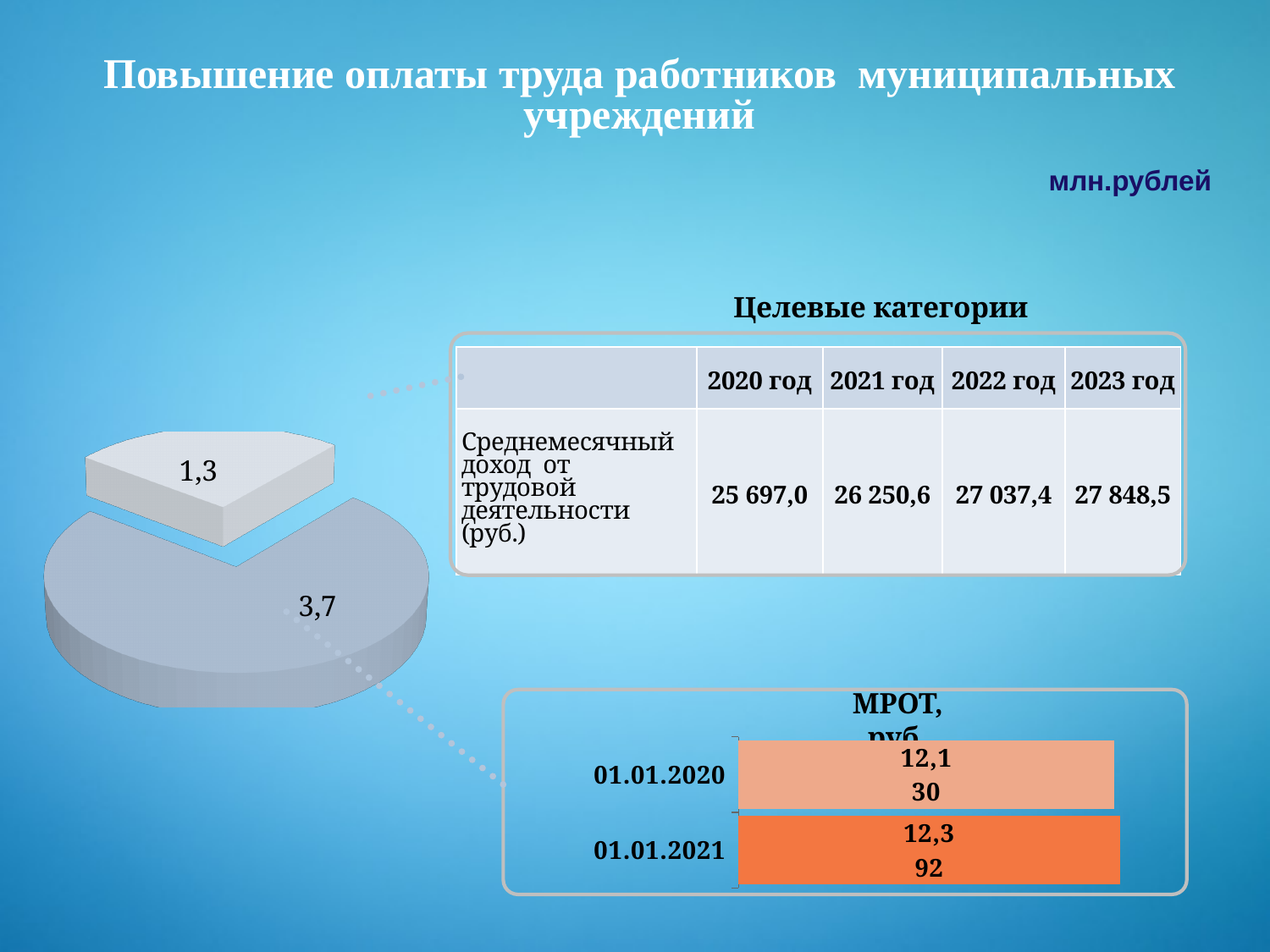
In the bar chart at the bottom right, how many categories are shown? 2 In the pie chart on the left, what is the value of the largest slice? 3,7 What type of chart is shown at the bottom right of the slide? bar chart In the bar chart at the bottom right, which category has the longer bar, 01.01.2020 or 01.01.2021? 01.01.2021 In the pie chart on the left, what share of the total does the slice labelled 3,7 represent? 74% What is the title of the bar chart at the bottom right of the slide? МРОТ, руб. What type of chart is shown on the left side of the slide? pie chart In the pie chart on the left, what is the value of the smallest slice? 1,3 In the pie chart on the left, how many slices are there? 2 In the pie chart on the left, what is the difference between the two slice values? 2,4 In the pie chart on the left, which slice is larger, the one labelled 1,3 or the one labelled 3,7? 3,7 In the pie chart on the left, what is the total of the two slice values? 5,0